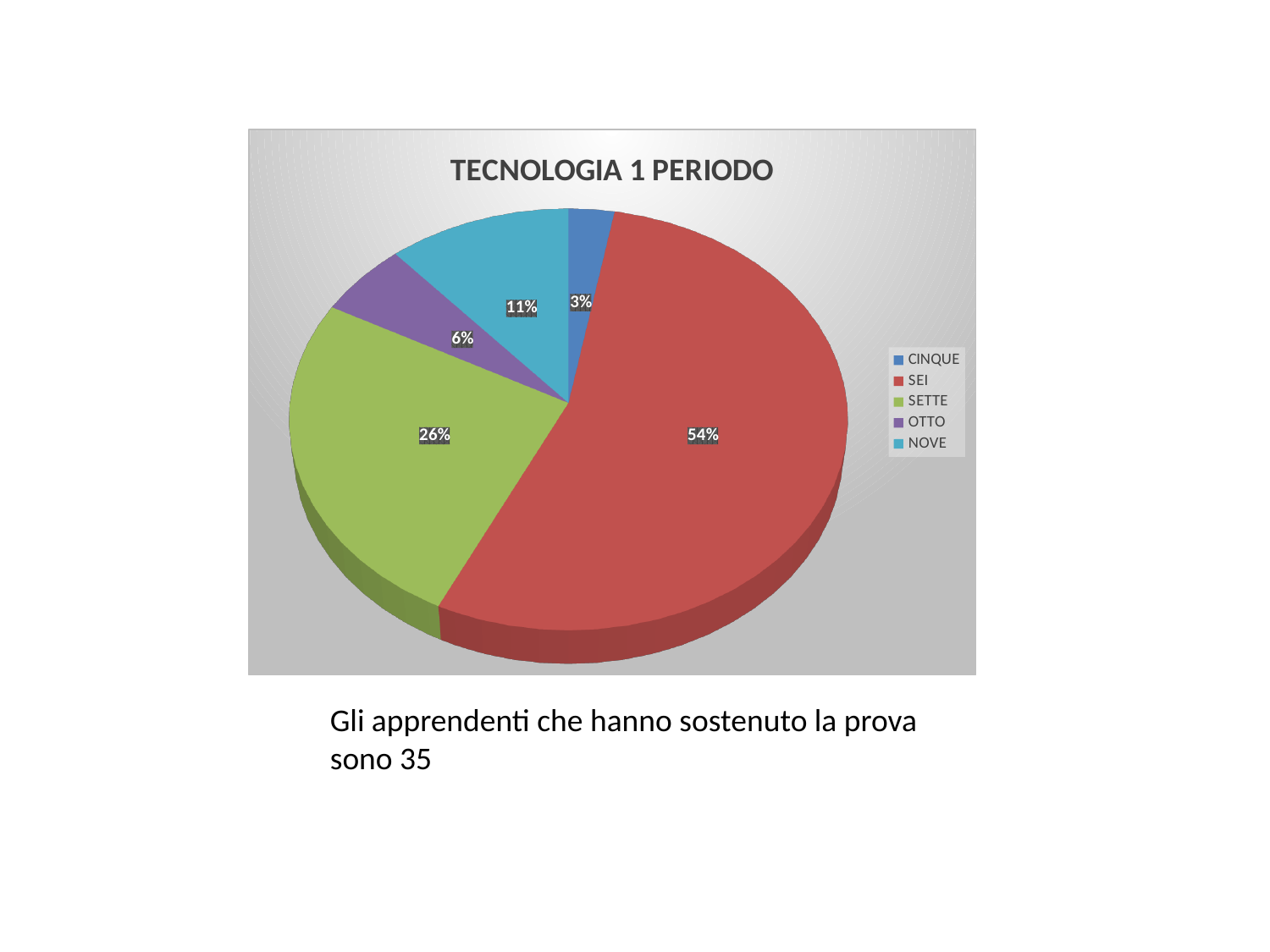
Which category has the smallest slice of the pie? CINQUE How many categories does the legend list? 5 What share of the pie does SEI represent? 54% What share of the pie does SETTE represent? 26% What share of the pie does OTTO represent? 6% Which category has the largest slice of the pie? SEI What is the title of the chart? TECNOLOGIA 1 PERIODO What is the difference in percentage points between the SEI and SETTE slices? 28 Which slice is larger, NOVE or OTTO? NOVE What type of chart is shown on the slide? Pie chart